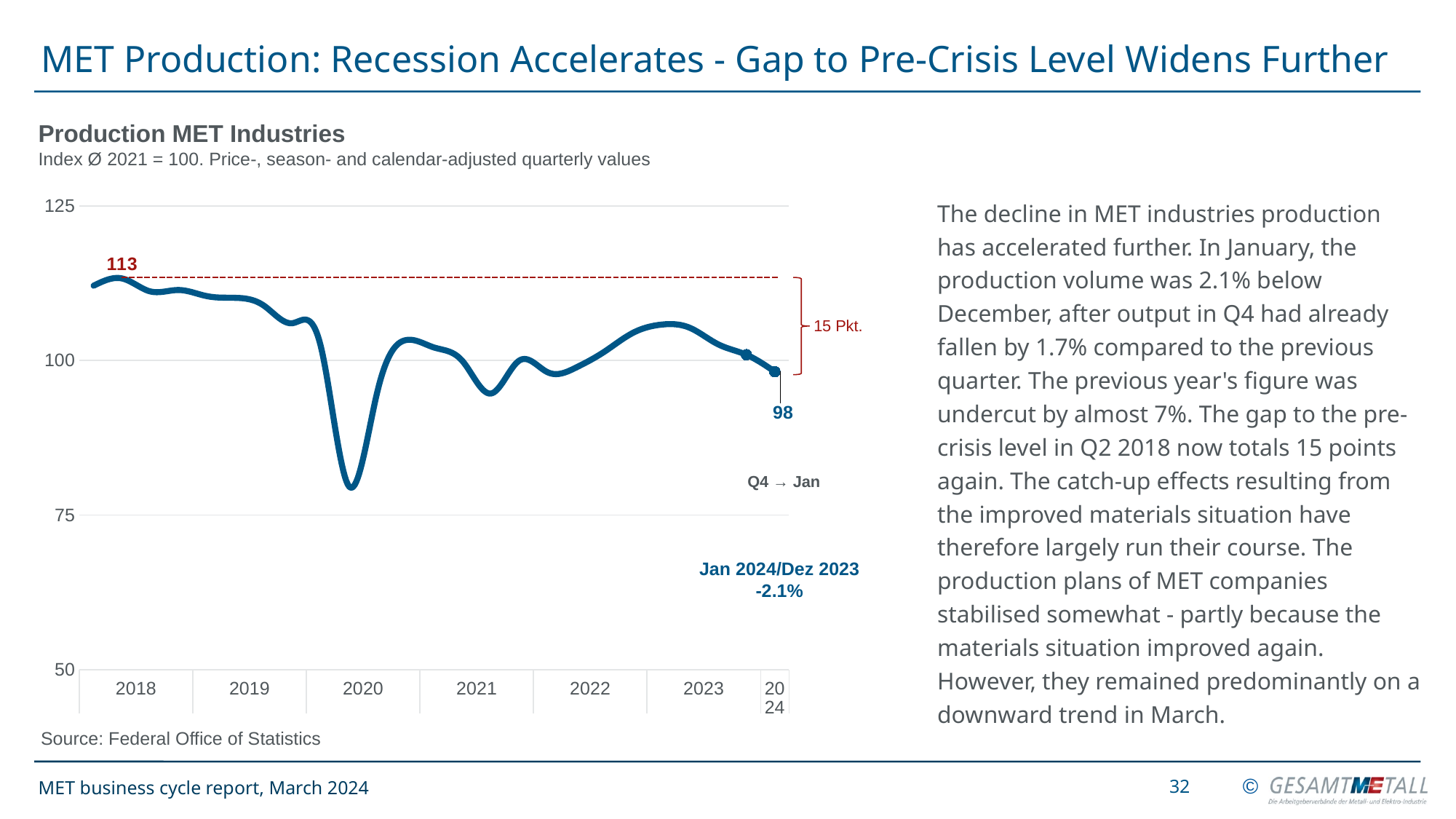
How large is the gap between the pre-crisis peak (113) and the latest value (98), as annotated on the chart? 15 Pkt. What is the title of the chart? Production MET Industries What source is given for the chart data? Federal Office of Statistics Does the line rise or fall from 2023 to January 2024? fall Which is larger, the pre-crisis peak value or the January 2024 value? the pre-crisis peak value (113) What kind of chart is shown on the slide? line chart What is the labelled peak value of the production index shown on the chart? 113 What is the labelled value of the production index at the end of the line (January 2024)? 98 What percentage change is shown for Jan 2024 compared with Dez 2023? -2.1% Is the value of the index at the start of 2018 greater or less than 100? greater In which year does the line reach its lowest point? 2020 Is the lowest point of the line in 2020 greater or less than 100? less